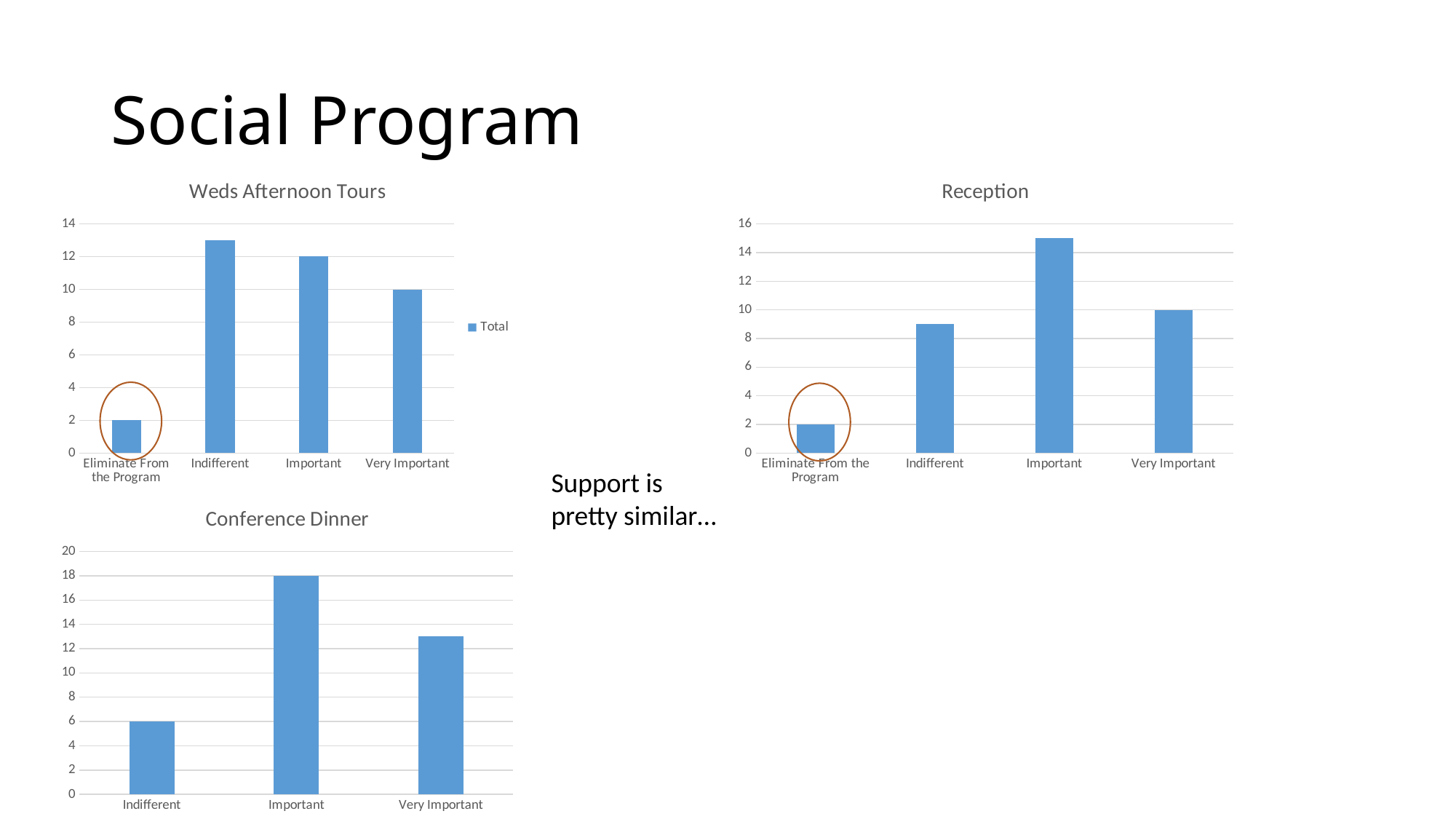
In the Weds Afternoon Tours chart, what is the value for Eliminate From the Program? 2 In the Reception chart, is the value for Indifferent greater or less than 10? less In the Weds Afternoon Tours chart, what is the value for Important? 12 In the Weds Afternoon Tours chart, what is the difference between the values for Important and Very Important? 2 In the Reception chart, what is the value for Very Important? 10 In the Conference Dinner chart, what is the value for Important? 18 In the Conference Dinner chart, what is the value for Indifferent? 6 In the Reception chart, which category has the highest value? Important How many categories are shown in the Conference Dinner chart? 3 How many series does the legend of the Weds Afternoon Tours chart list? 1 In the Conference Dinner chart, is the value for Very Important greater or less than 12? greater In the Weds Afternoon Tours chart, which category has the lowest value? Eliminate From the Program